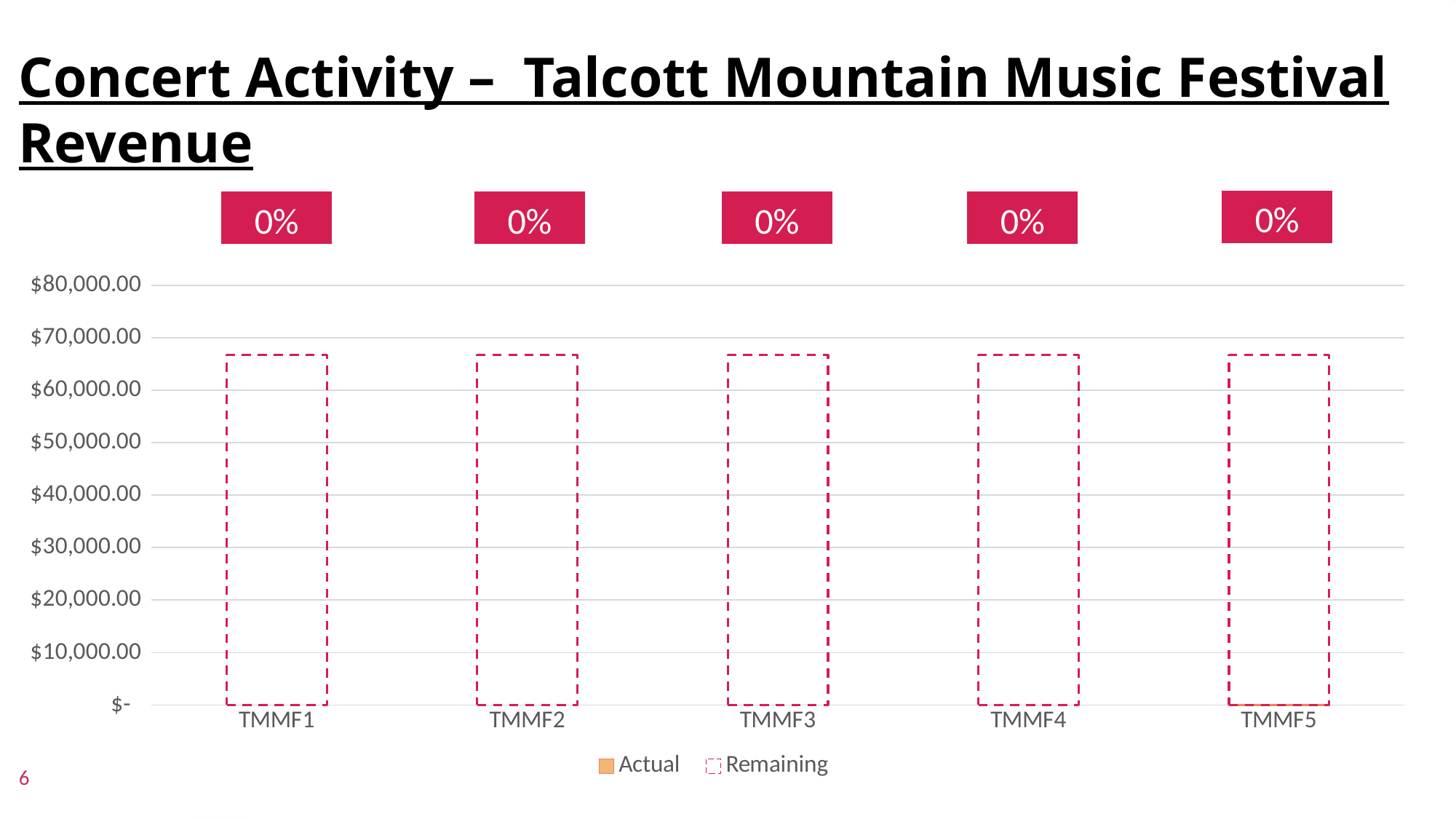
What percentage is shown in the label above the TMMF1 bar? 0% How many categories are shown on the x axis of the chart? 5 What percentage is shown in the label above the TMMF5 bar? 0% How many series does the chart's legend list? 2 Is the Remaining value for TMMF3 greater or less than $70,000.00? less What is the label of the first category on the x axis? TMMF1 What is the highest value shown on the chart's y axis? $80,000.00 What kind of chart is shown on the slide? bar chart Is the Remaining value for TMMF1 greater or less than $60,000.00? greater What are the two series named in the chart's legend? Actual and Remaining Is the Remaining value for TMMF5 greater or less than $50,000.00? greater